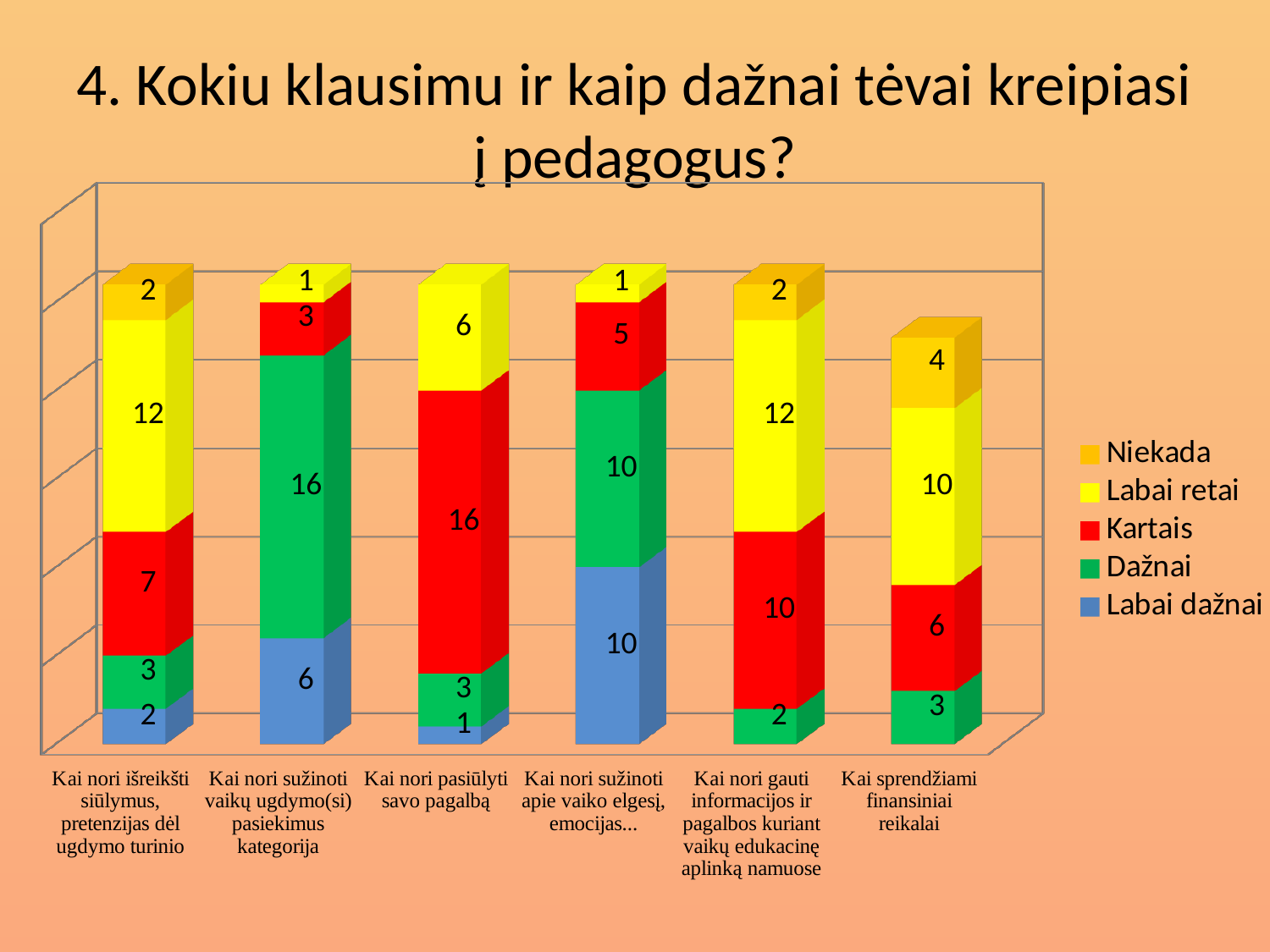
Which is larger: the "Kartais" value for "Kai nori gauti informacijos ir pagalbos kuriant vaikų edukacinę aplinką namuose" or for "Kai sprendžiami finansiniai reikalai"? Kai nori gauti informacijos ir pagalbos kuriant vaikų edukacinę aplinką namuose How many series does the legend list? 5 What is the value of "Labai dažnai" for "Kai nori sužinoti apie vaiko elgesį, emocijas..."? 10 What is the value of "Niekada" for "Kai sprendžiami finansiniai reikalai"? 4 Which category has the highest "Labai dažnai" value? Kai nori sužinoti apie vaiko elgesį, emocijas... What is the difference between the "Labai retai" values for "Kai nori išreikšti siūlymus, pretenzijas dėl ugdymo turinio" and "Kai nori pasiūlyti savo pagalbą"? 6 What is the value of "Dažnai" for "Kai nori sužinoti vaikų ugdymo(si) pasiekimus kategorija"? 16 Which colour represents the "Kartais" series in the legend? red What kind of chart is shown on the slide? stacked bar chart What is the value of "Kartais" for "Kai nori pasiūlyti savo pagalbą"? 16 How many categories are shown along the x axis? 6 What is the total of the stacked bar for "Kai sprendžiami finansiniai reikalai"? 23